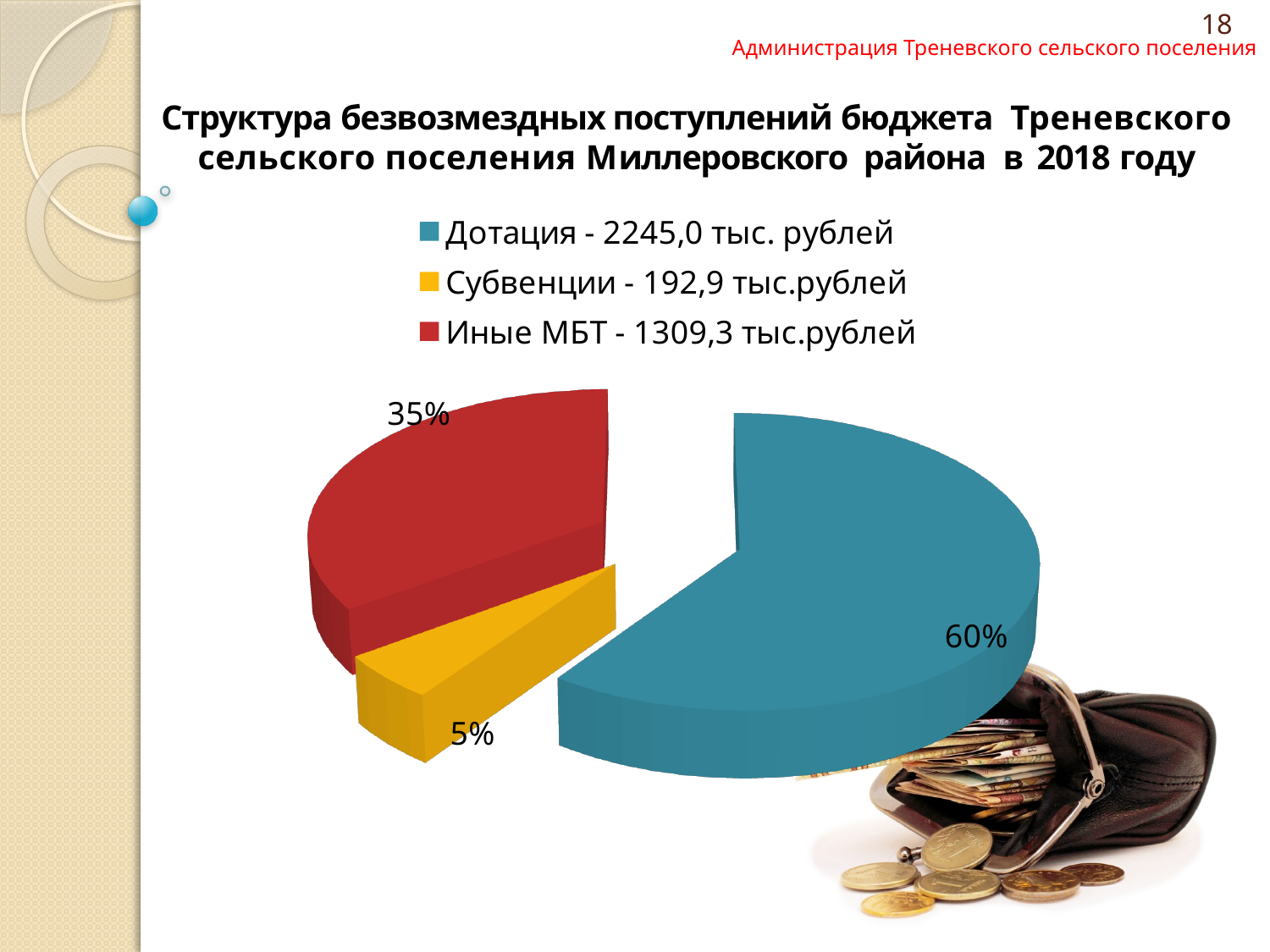
What share of the pie does Субвенции take? 5% What share of the pie does Иные МБТ take? 35% What share of the pie does Дотация take? 60% How many entries does the legend list? 3 What is the difference in percentage points between the Дотация slice and the Иные МБТ slice? 25% Which category has the smallest slice of the pie? Субвенции Which category has the largest slice of the pie? Дотация What colour is the Иные МБТ slice in the pie chart? Red Which is larger, the Иные МБТ slice or the Субвенции slice? Иные МБТ What kind of chart is shown on the slide? Pie chart How many slices does the pie chart have? 3 According to the legend, what amount in тыс. рублей corresponds to Субвенции? 192,9 тыс.рублей